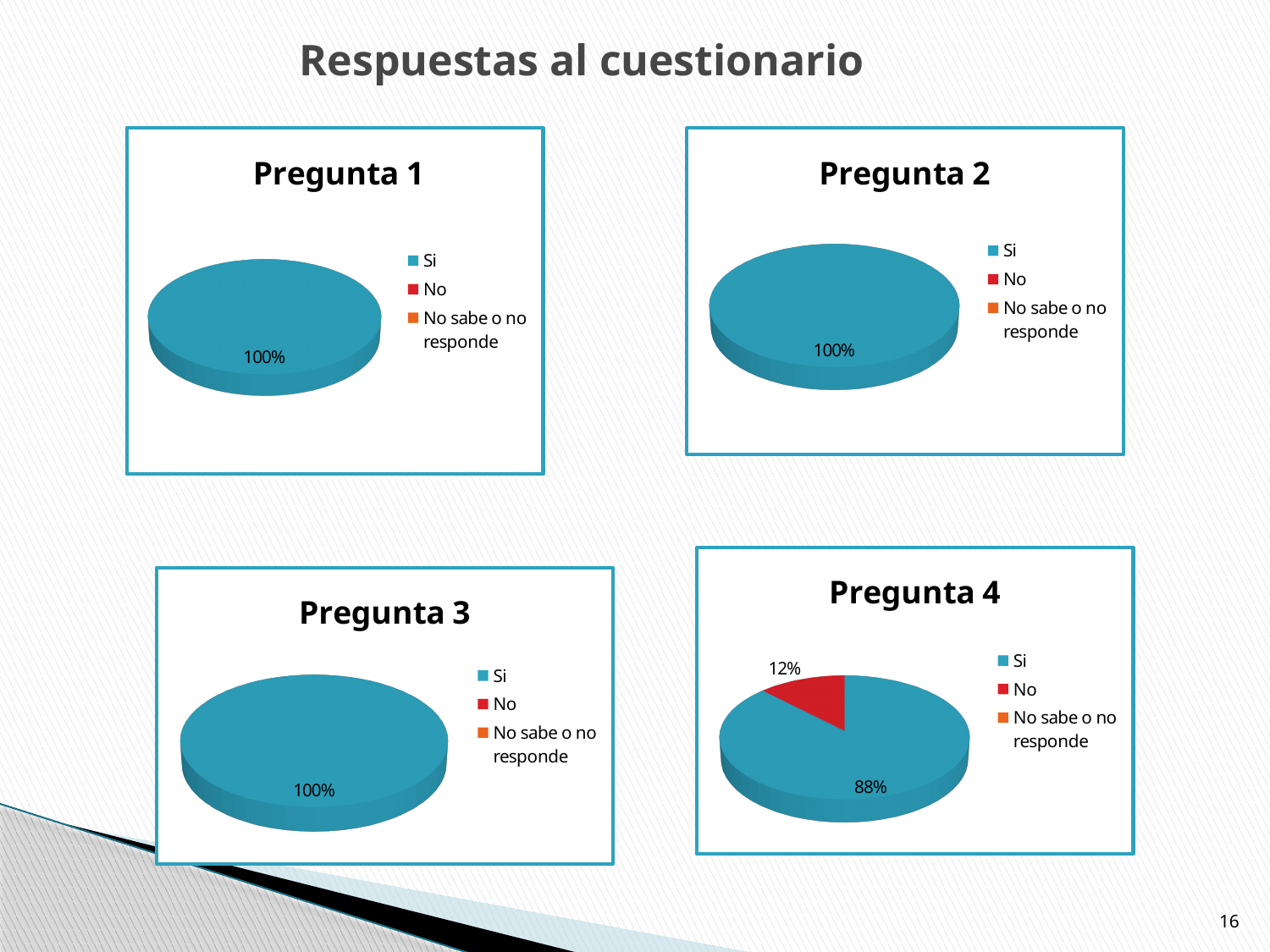
What kind of chart is the Pregunta 1 chart? Pie chart In the Pregunta 4 chart, which is larger, the Si slice or the No slice? Si In the Pregunta 4 chart, which category has the largest slice? Si How many entries does the legend of the Pregunta 4 chart list? 3 How many charts are shown on the slide? 4 What is the title of the chart in the bottom-right of the slide? Pregunta 4 In the Pregunta 1 chart, what percentage is shown for Si? 100% In the Pregunta 4 chart, what share of the pie is labelled for No? 12% In the Pregunta 3 chart, what percentage is shown for Si? 100% In the Pregunta 4 chart, what is the difference between the Si and No shares? 76% In the Pregunta 4 chart, what share of the pie is labelled for Si? 88% In the Pregunta 2 chart, what percentage is shown for Si? 100%